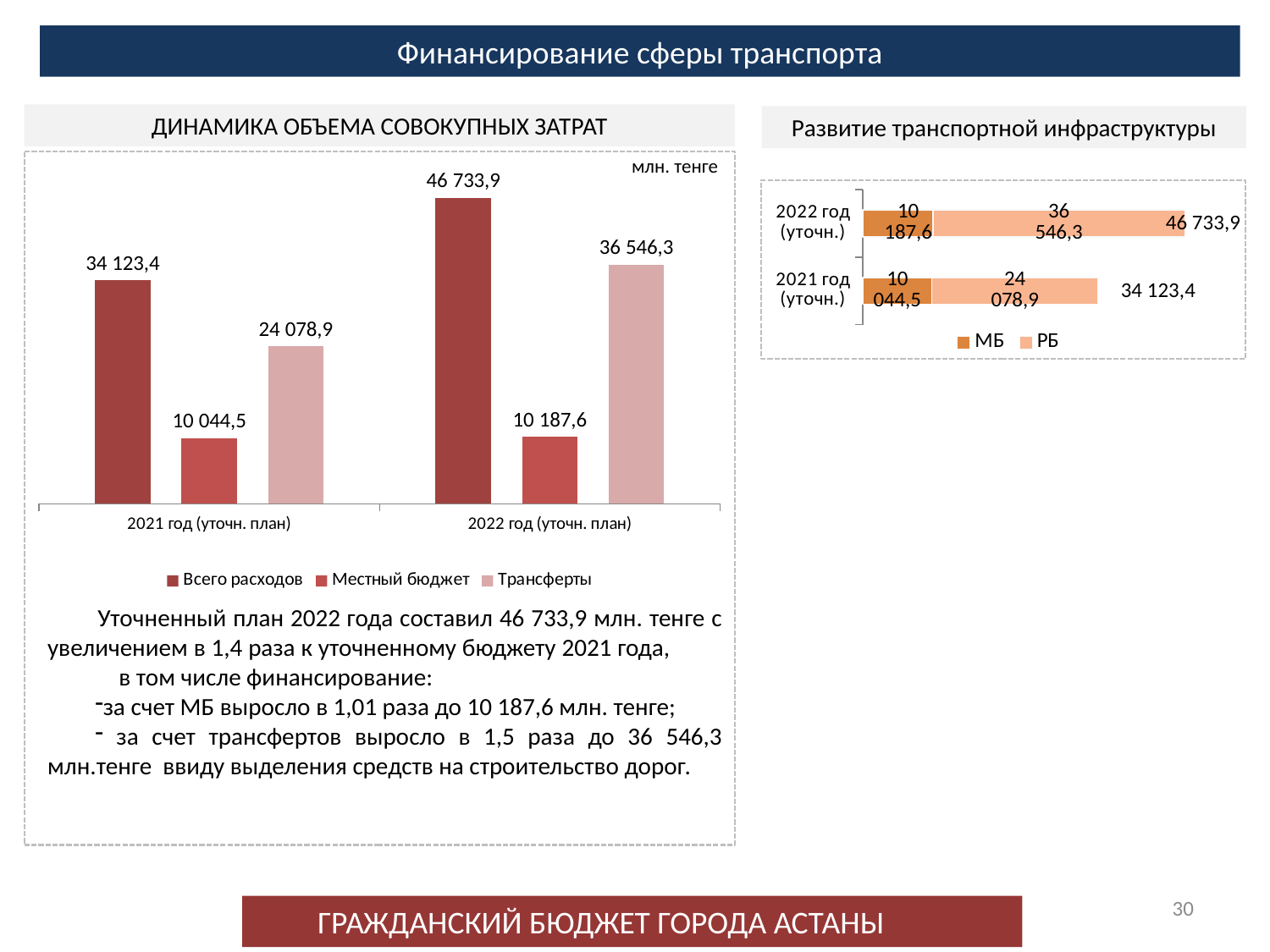
In the chart 'Развитие транспортной инфраструктуры', what is the value of РБ for 2022 год (уточн.)? 36 546,3 In the chart 'ДИНАМИКА ОБЪЕМА СОВОКУПНЫХ ЗАТРАТ', what is the value of 'Местный бюджет' for 2022 год (уточн. план)? 10 187,6 In the chart 'ДИНАМИКА ОБЪЕМА СОВОКУПНЫХ ЗАТРАТ', what kind of chart is shown? Bar chart In the chart 'Развитие транспортной инфраструктуры', what is the total of the stacked bar for 2021 год (уточн.)? 34 123,4 In the chart 'ДИНАМИКА ОБЪЕМА СОВОКУПНЫХ ЗАТРАТ', which is larger: 'Трансферты' for 2021 год (уточн. план) or 'Трансферты' for 2022 год (уточн. план)? 2022 год (уточн. план) In the chart 'ДИНАМИКА ОБЪЕМА СОВОКУПНЫХ ЗАТРАТ', how many series does the legend list? 3 In the chart 'ДИНАМИКА ОБЪЕМА СОВОКУПНЫХ ЗАТРАТ', what unit is indicated in the top right corner of the plot area? млн. тенге In the chart 'Развитие транспортной инфраструктуры', what is the difference between РБ for 2022 год (уточн.) and РБ for 2021 год (уточн.)? 12 467,4 In the chart 'ДИНАМИКА ОБЪЕМА СОВОКУПНЫХ ЗАТРАТ', what is the value of 'Всего расходов' for 2022 год (уточн. план)? 46 733,9 In the chart 'ДИНАМИКА ОБЪЕМА СОВОКУПНЫХ ЗАТРАТ', what is the value of 'Трансферты' for 2021 год (уточн. план)? 24 078,9 In the chart 'ДИНАМИКА ОБЪЕМА СОВОКУПНЫХ ЗАТРАТ', what is the difference between 'Всего расходов' in 2022 год (уточн. план) and in 2021 год (уточн. план)? 12 610,5 In the chart 'Развитие транспортной инфраструктуры', how many series does the legend list? 2